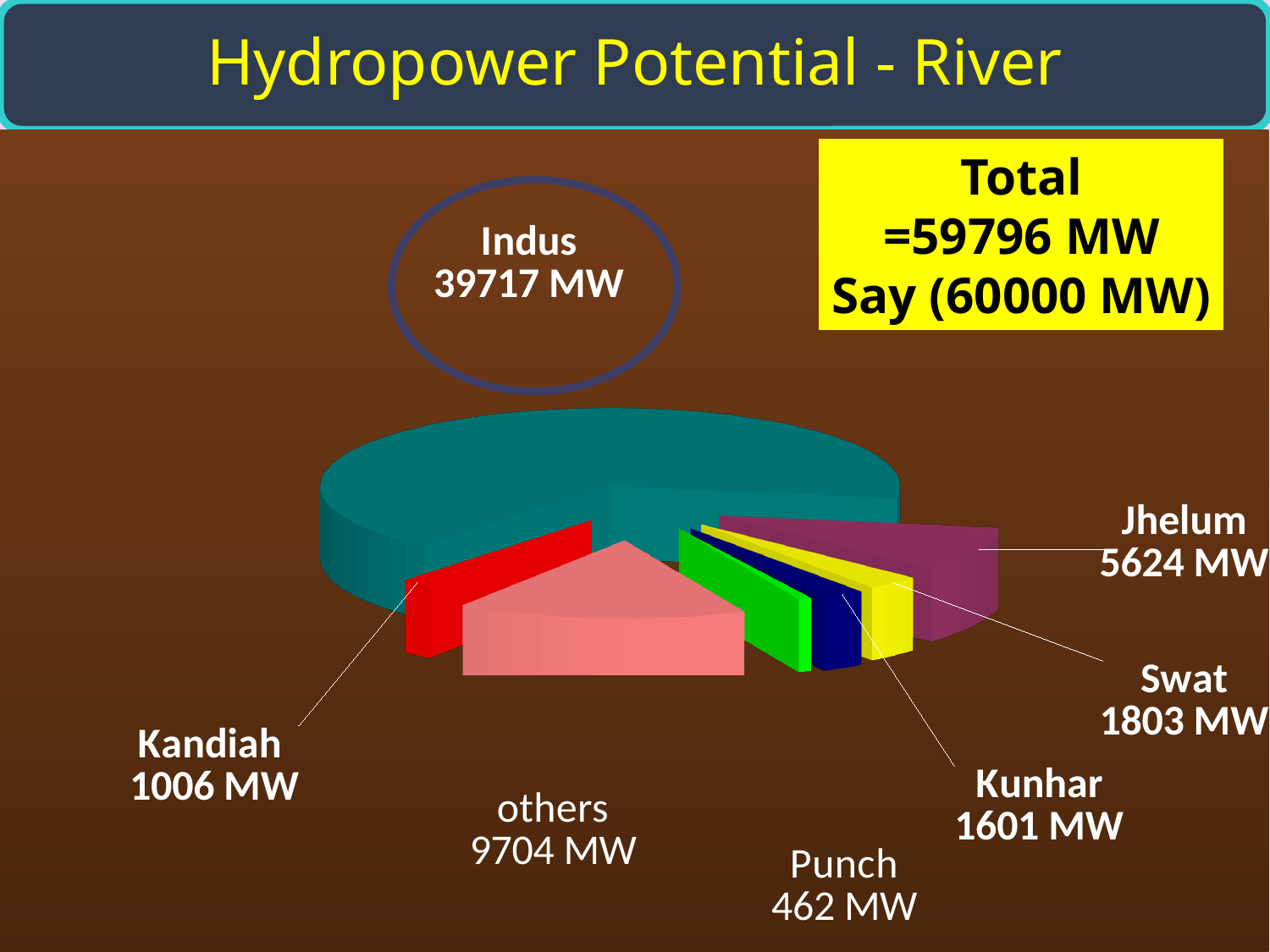
What kind of chart is shown on the slide? pie chart What is the hydropower potential of the Jhelum river? 5624 MW Which river has the smallest hydropower potential in the chart? Punch What is the hydropower potential of the Punch river? 462 MW Which river has the largest hydropower potential in the chart? Indus How many slices does the pie chart have? 7 What is the hydropower potential of the Kunhar river? 1601 MW What value is shown for the 'others' slice? 9704 MW What is the difference between the hydropower potential of Jhelum and Swat? 3821 MW What is the hydropower potential of the Indus river? 39717 MW Which has a larger hydropower potential, Swat or Kunhar? Swat What is the title of the slide? Hydropower Potential - River